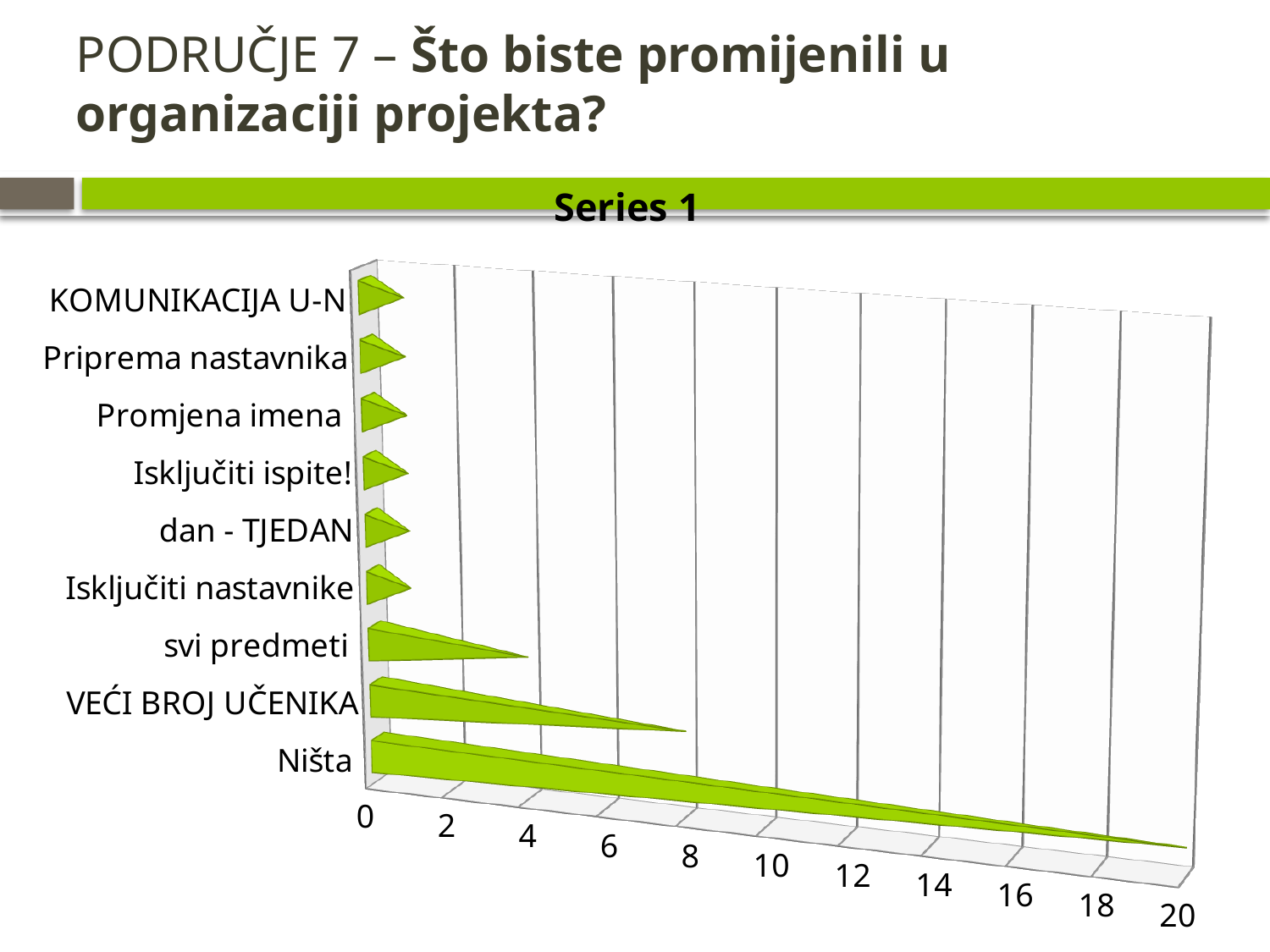
What is the maximum value shown on the horizontal axis? 20 Which is larger, the value for Ništa or the value for Isključiti ispite!? Ništa What kind of chart is shown on the slide? bar chart What is the title shown above the chart? Series 1 Is the value for Ništa greater or less than 14? greater Is the value for svi predmeti greater or less than 8? less Which is larger, the value for VEĆI BROJ UČENIKA or the value for svi predmeti? VEĆI BROJ UČENIKA Which category has the highest value? Ništa Is the value for VEĆI BROJ UČENIKA greater or less than 12? less How many categories are plotted on the chart? 9